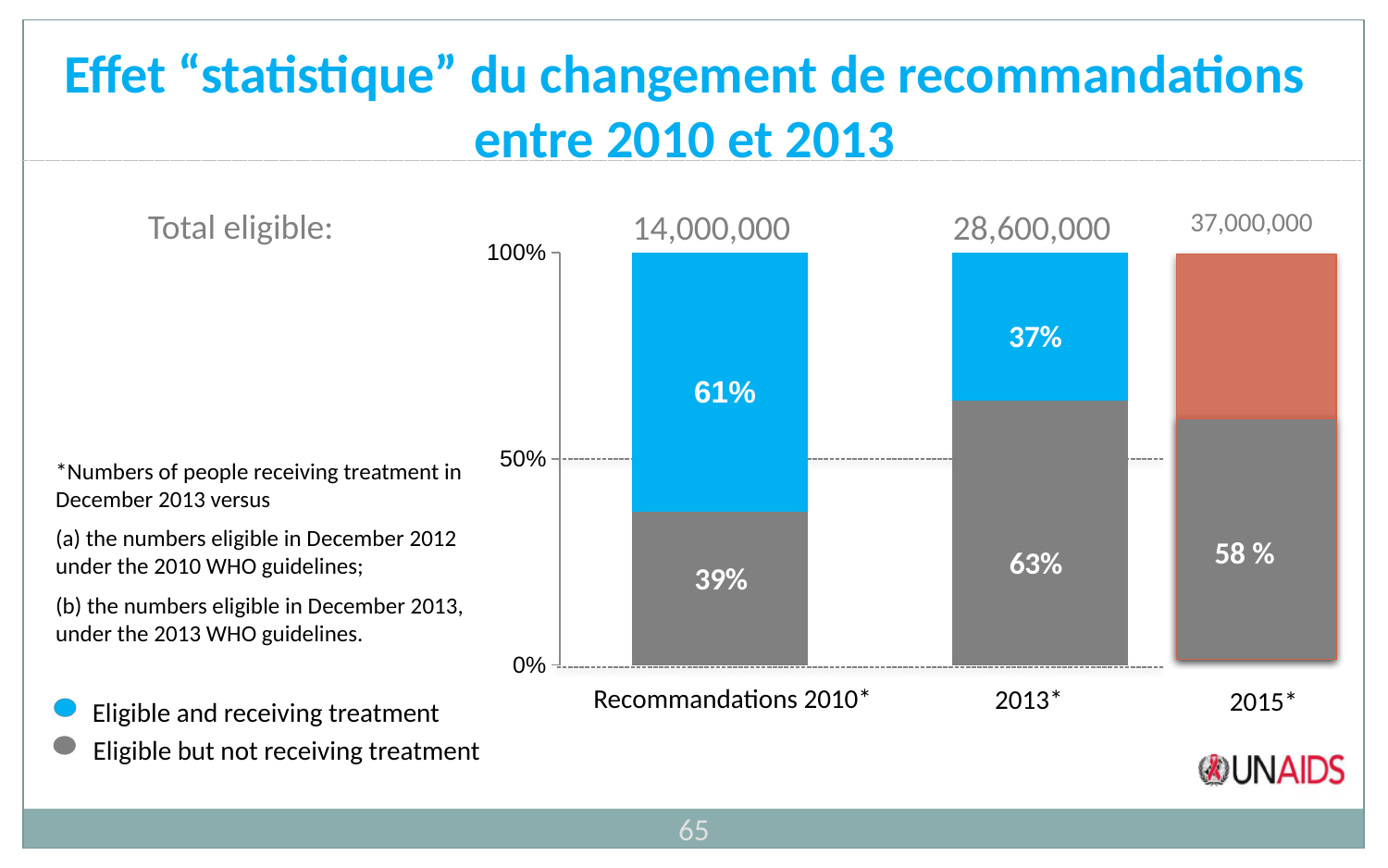
What is the 'Eligible but not receiving treatment' value shown for the 2015* bar? 58 % What is the total eligible number shown above the 2015* bar? 37,000,000 Is the 'Eligible and receiving treatment' share larger for Recommandations 2010* or for 2013*? Recommandations 2010* How many entries does the legend list? 2 Is the 'Eligible but not receiving treatment' value for 2015* greater or less than 50%? greater What percentage of eligible people were receiving treatment under the Recommandations 2010* bar? 61% How many bars are shown in the chart? 3 What is the difference between the 'Eligible but not receiving treatment' percentages for 2013* and Recommandations 2010*? 24% Which bar has the highest 'Eligible and receiving treatment' percentage? Recommandations 2010* What percentage of eligible people were not receiving treatment under the 2013* bar? 63% What kind of chart is shown on the slide? Stacked bar chart What is the total eligible number shown above the 2013* bar? 28,600,000